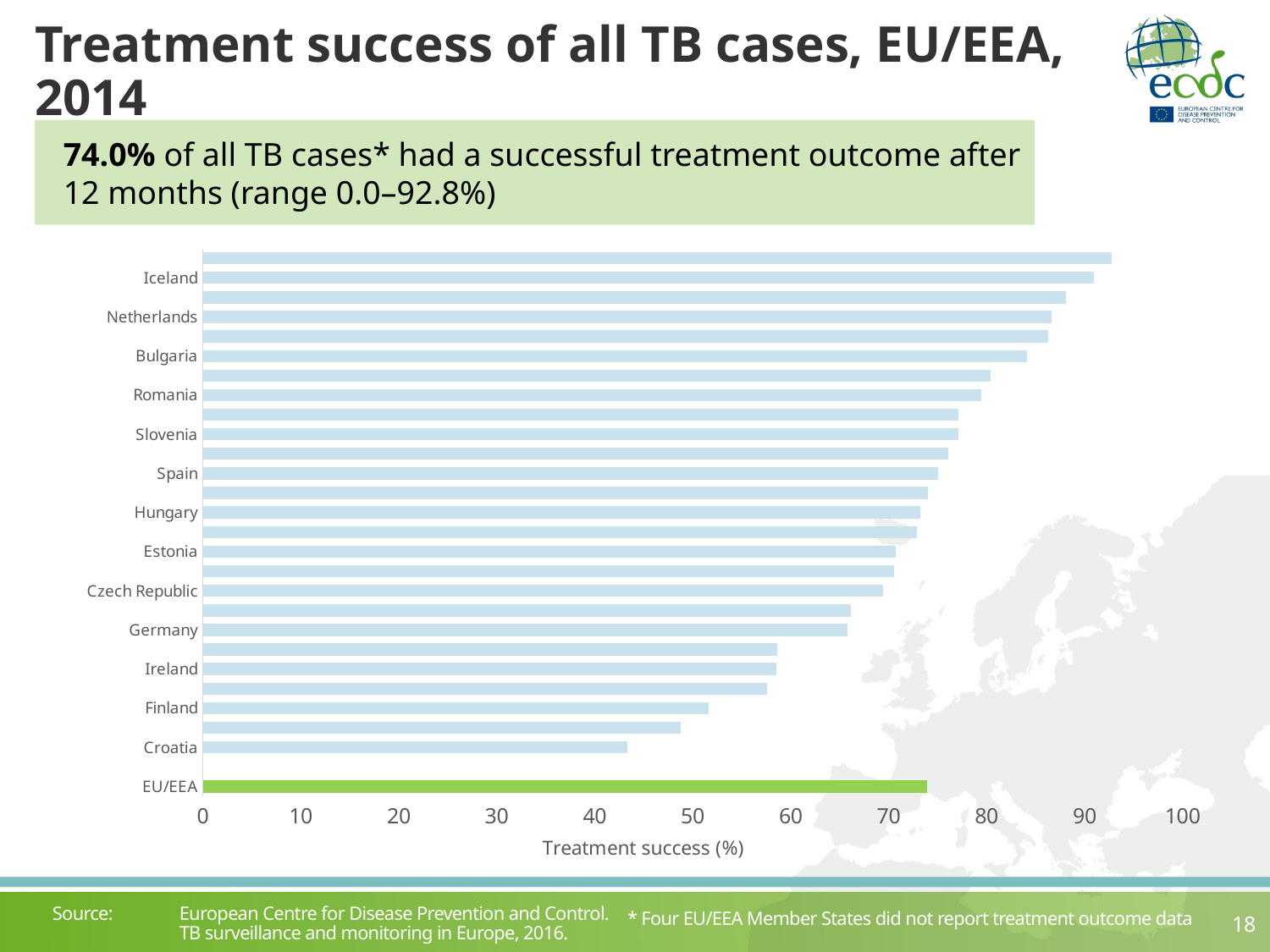
What kind of chart is shown on the slide? bar chart Among the labelled countries, which has the highest treatment success? Iceland Is the treatment success value for Croatia greater or less than 50? less Is the treatment success value for Ireland greater or less than 60? less Is the treatment success value for Slovenia greater or less than 70? greater Do the bar values rise or fall going from the top of the chart to the bottom? fall Which has a higher treatment success, Germany or Netherlands? Netherlands Among the labelled countries, which has the lowest treatment success? Croatia What is the treatment success value for EU/EEA? 74.0% What is the title of the horizontal axis? Treatment success (%)